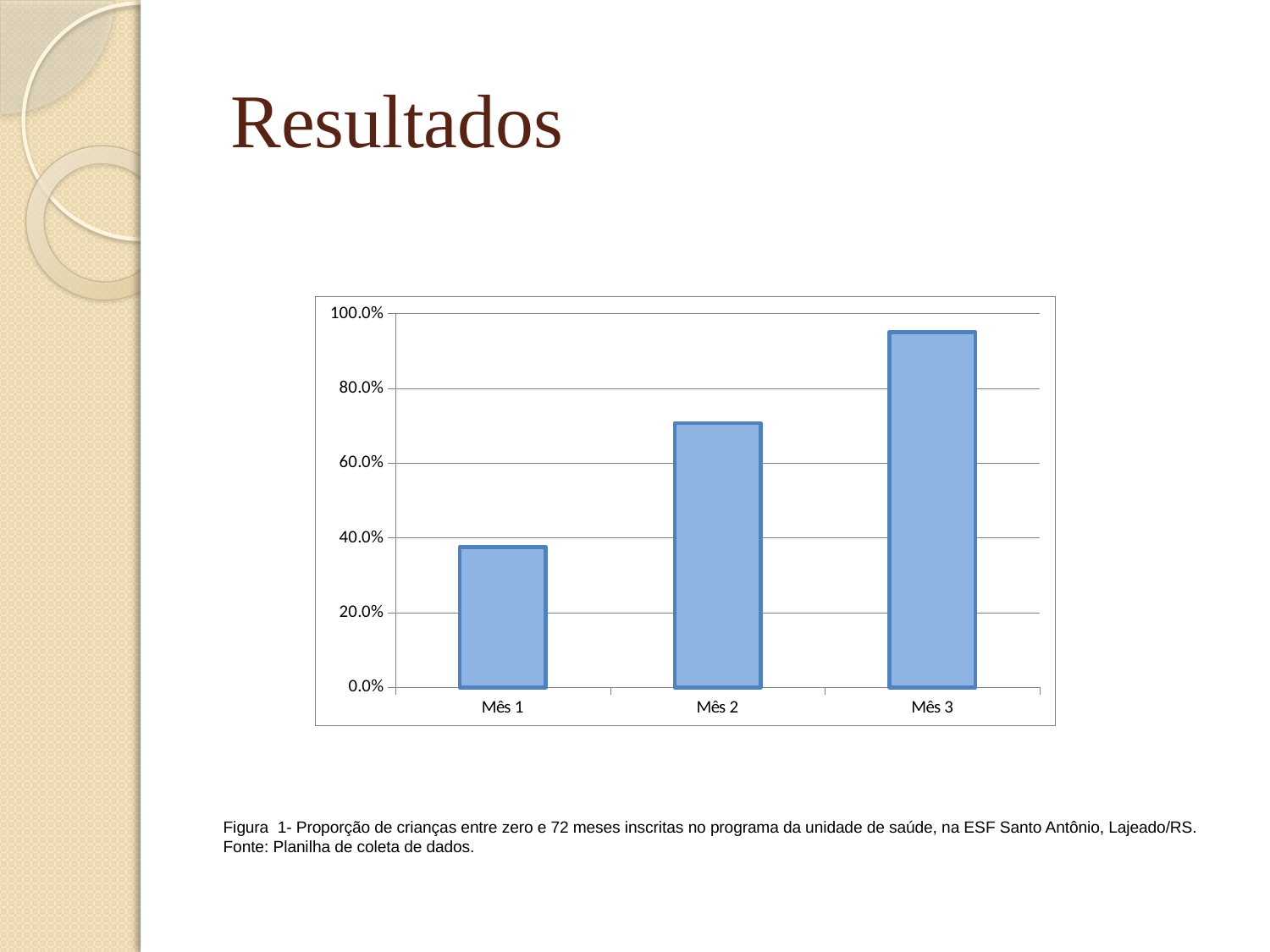
Is the value for Mês 2 greater or less than 80.0%? less Is the value for Mês 2 greater or less than 60.0%? greater What is the label of the highest tick on the vertical axis? 100.0% Is the value for Mês 3 greater or less than 80.0%? greater Which month has the highest bar in the chart? Mês 3 What is the title of the slide containing the chart? Resultados Which month has the lowest bar in the chart? Mês 1 Which is larger, the value for Mês 1 or the value for Mês 2? Mês 2 How many categories are plotted on the x axis of the chart? 3 What kind of chart is shown on the slide? bar chart Do the values rise or fall from Mês 1 to Mês 3? rise